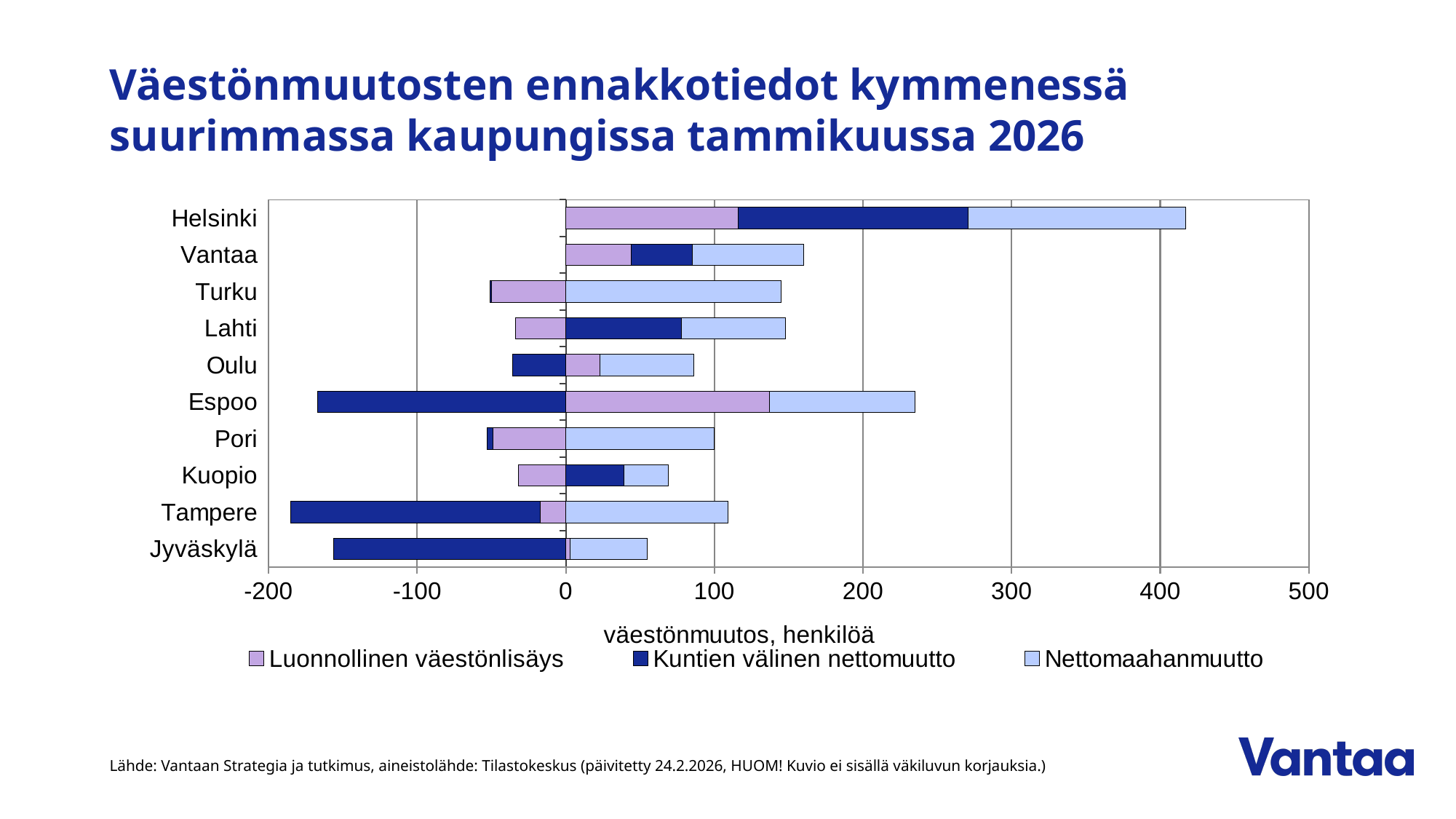
How many series does the chart's legend list? 3 What is the title of the chart on the slide? Väestönmuutosten ennakkotiedot kymmenessä suurimmassa kaupungissa tammikuussa 2026 Is the right end of Vantaa's stacked bar greater or less than 100? greater Is the Kuntien välinen nettomuutto value for Espoo greater or less than -100? less Is the right end of Helsinki's stacked bar greater or less than 400? greater What label is shown on the horizontal axis of the chart? väestönmuutos, henkilöä How many cities are listed on the vertical axis of the chart? 10 Which city's bar extends furthest to the right on the chart? Helsinki What kind of chart is shown on the slide? Stacked bar chart